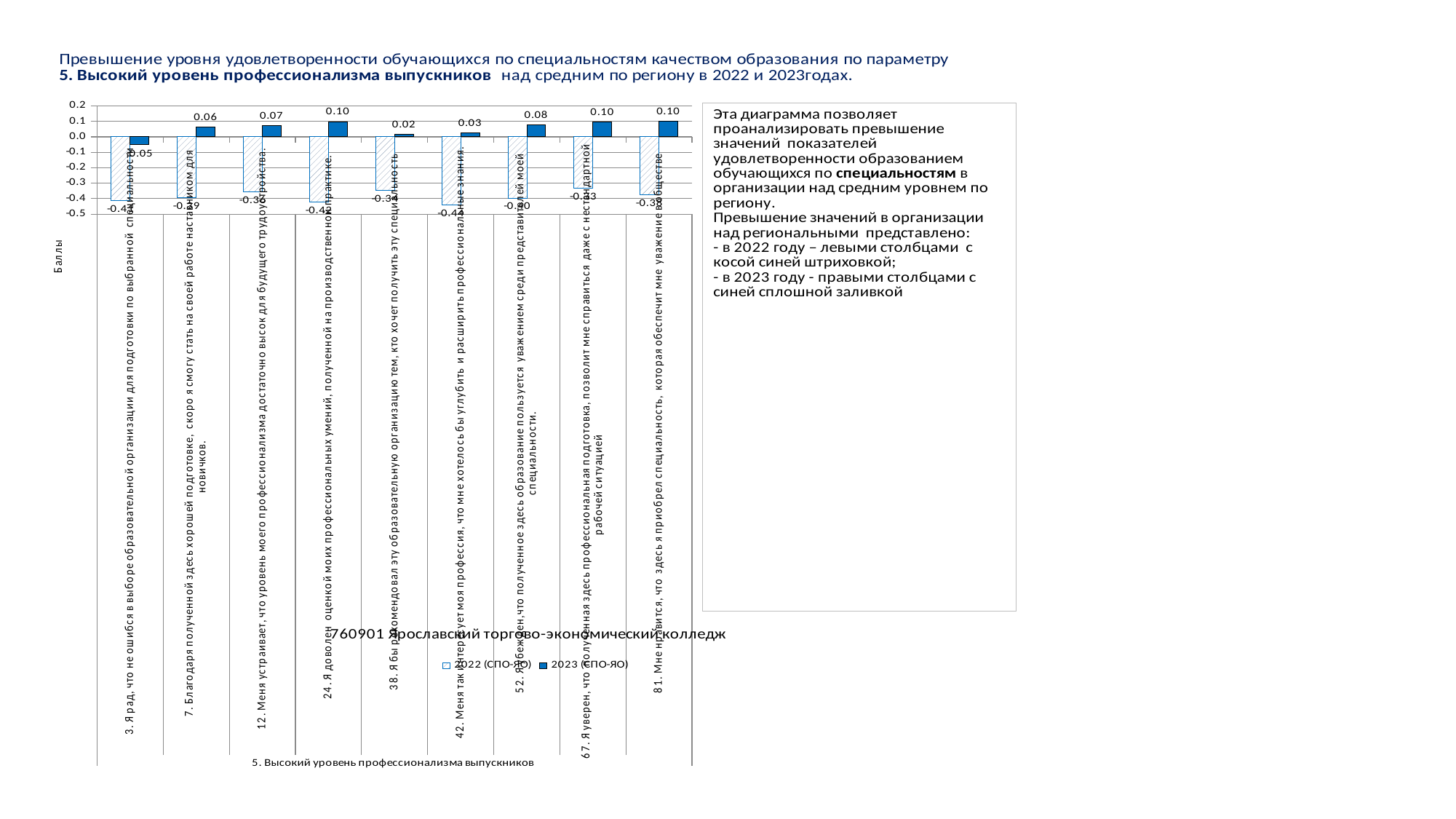
What is the difference between the 2023 (СПО-ЯО) values for item 67 and item 38? 0.08 What is the 2023 (СПО-ЯО) value for item 7 (Благодаря полученной здесь хорошей подготовке...)? 0.06 Is the 2022 (СПО-ЯО) value for item 42 greater or less than -0.4? less How many categories (survey items) are plotted on the x axis? 9 What is the 2022 (СПО-ЯО) value for item 7 (Благодаря полученной здесь хорошей подготовке...)? -0.39 What is the 2022 (СПО-ЯО) value for item 67 (Я уверен, что полученная здесь профессиональная подготовка...)? -0.33 What is the label on the vertical axis of the chart? Баллы How many series does the chart legend list? 2 Which has the larger 2023 (СПО-ЯО) value: item 24 or item 38? Item 24 What is the 2023 (СПО-ЯО) value for item 3 (Я рад, что не ошибся в выборе образовательной организации...)? -0.05 Which item has the lowest 2023 (СПО-ЯО) value? Item 3 (Я рад, что не ошибся в выборе образовательной организации...) What kind of chart is shown on the slide? bar chart